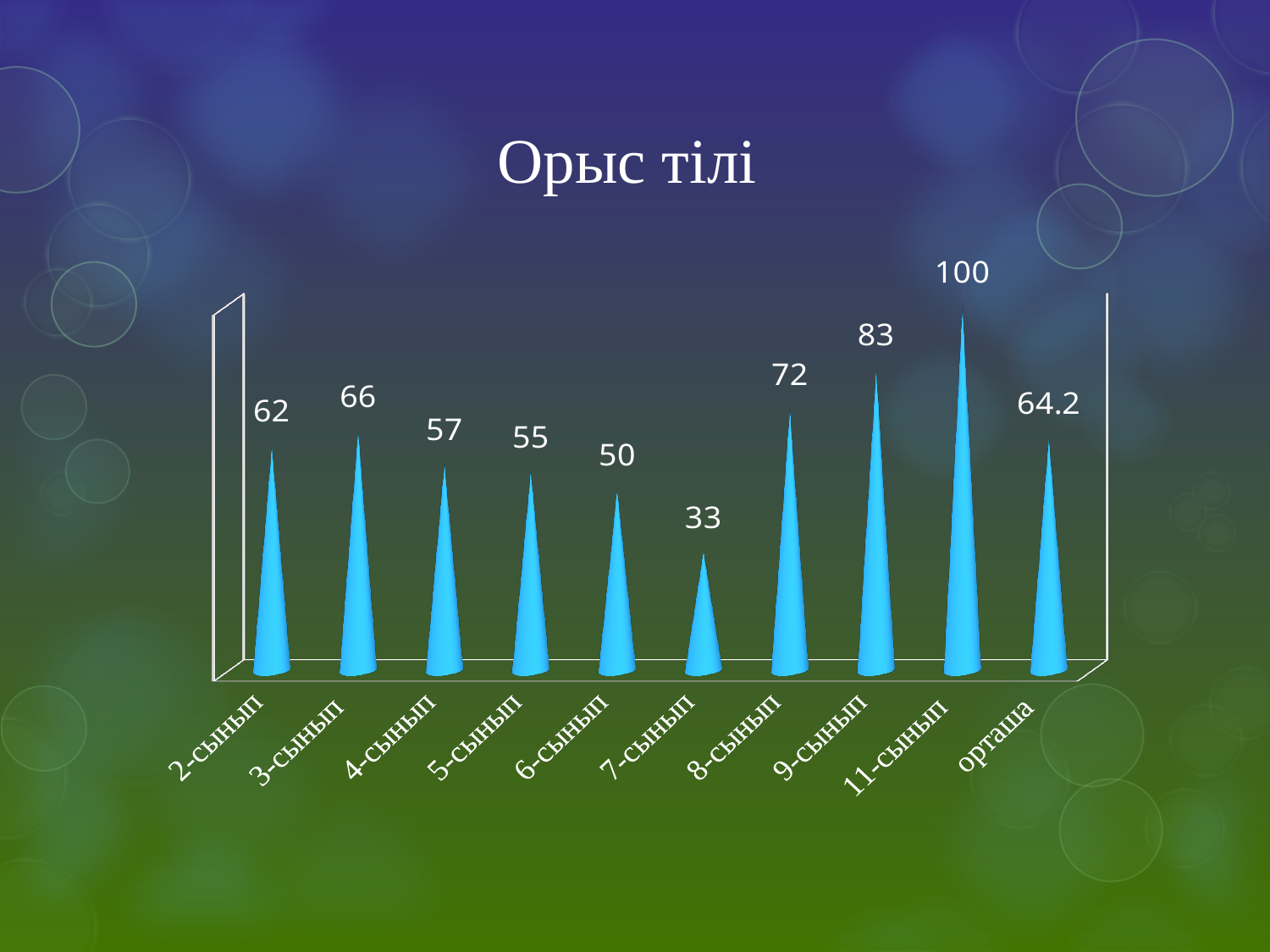
What is the value for 7-сынып? 33 What kind of chart is shown on the slide? bar chart What is the difference between the values for 9-сынып and 8-сынып? 11 What is the title of the chart? Орыс тілі What is the value for 2-сынып? 62 Which is larger, the value for 3-сынып or the value for 4-сынып? 3-сынып Which category has the lowest value? 7-сынып Which category has the highest value? 11-сынып What is the difference between the values for 11-сынып and 7-сынып? 67 What is the value for 6-сынып? 50 What is the value for орташа? 64.2 How many categories are shown on the x axis? 10